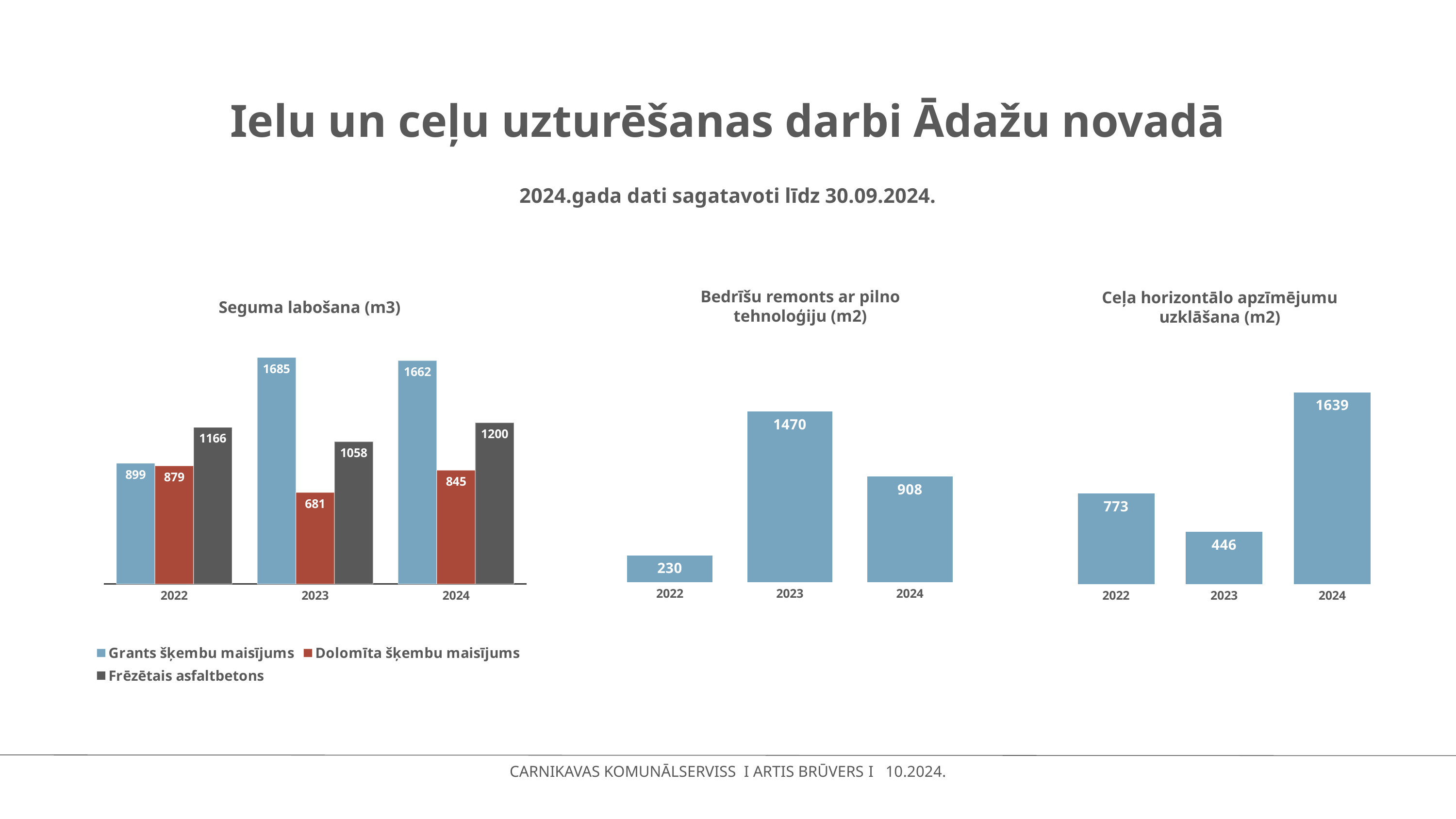
What kind of chart is the 'Bedrīšu remonts ar pilno tehnoloģiju (m2)' chart? bar chart In the 'Bedrīšu remonts ar pilno tehnoloģiju (m2)' chart, which year has the lowest value? 2022 In the 'Bedrīšu remonts ar pilno tehnoloģiju (m2)' chart, what is the value for 2023? 1470 In the 'Ceļa horizontālo apzīmējumu uzklāšana (m2)' chart, is the value for 2023 larger or smaller than the value for 2022? smaller In the 'Ceļa horizontālo apzīmējumu uzklāšana (m2)' chart, what is the value for 2022? 773 In the 'Bedrīšu remonts ar pilno tehnoloģiju (m2)' chart, what is the difference between 2023 and 2024? 562 In the 'Ceļa horizontālo apzīmējumu uzklāšana (m2)' chart, which year has the highest value? 2024 In the 'Seguma labošana (m3)' chart, what is the difference between Grants šķembu maisījums and Dolomīta šķembu maisījums in 2022? 20 In the 'Seguma labošana (m3)' chart, what is the value for Grants šķembu maisījums in 2023? 1685 How many series does the legend of the 'Seguma labošana (m3)' chart list? 3 In the 'Seguma labošana (m3)' chart, which year has the lowest value for Frēzētais asfaltbetons? 2023 In the 'Seguma labošana (m3)' chart, what is the value for Dolomīta šķembu maisījums in 2024? 845